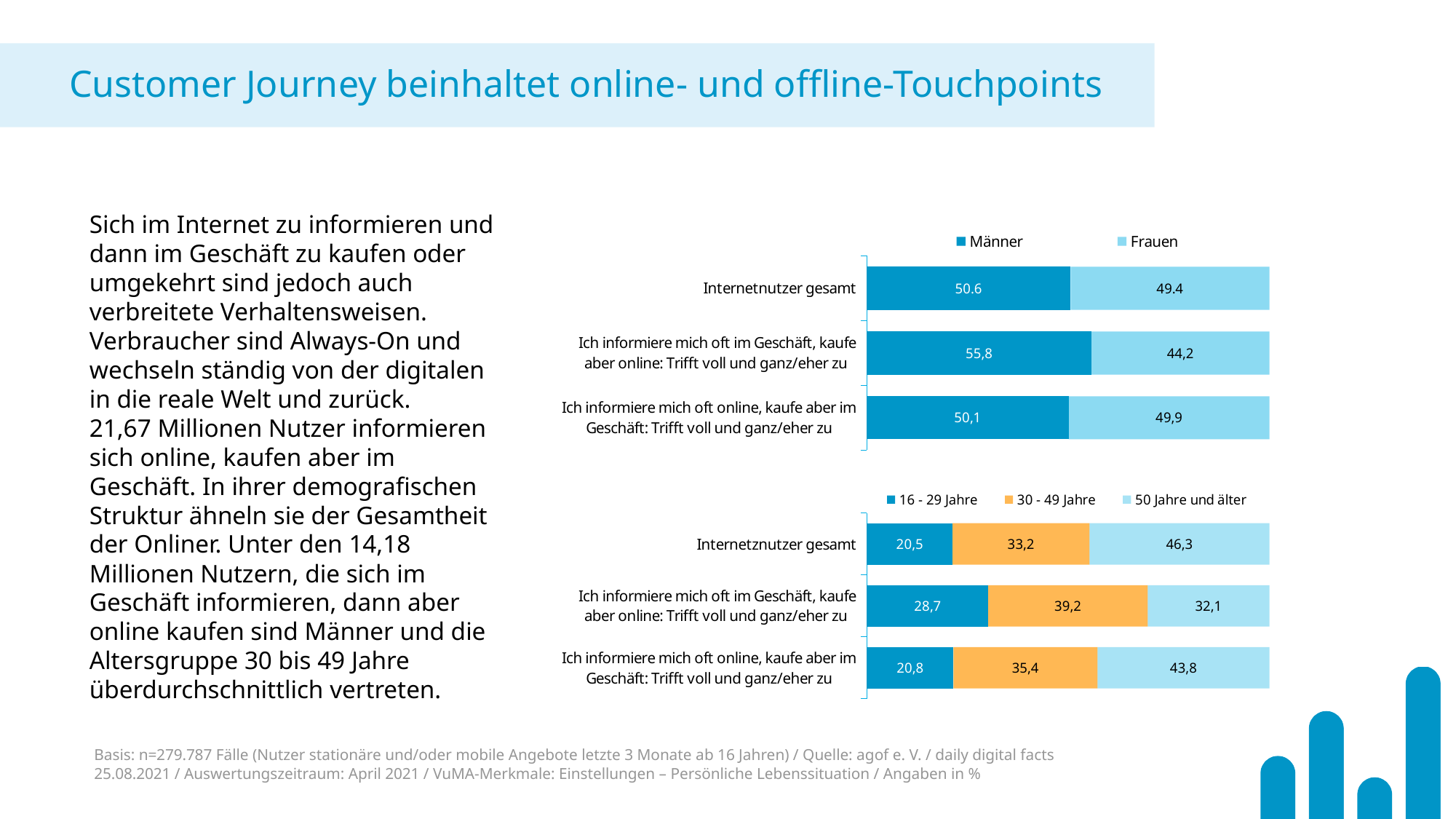
What kind of chart is the bottom chart (age groups)? Stacked bar chart In the top chart (Männer/Frauen), what is the Männer value for "Internetnutzer gesamt"? 50.6 In the bottom chart (age groups), what is the "30 - 49 Jahre" value for "Ich informiere mich oft im Geschäft, kaufe aber online"? 39,2 In the bottom chart (age groups), which category has the lowest "50 Jahre und älter" value? Ich informiere mich oft im Geschäft, kaufe aber online: Trifft voll und ganz/eher zu In the bottom chart (age groups), is the "16 - 29 Jahre" value larger for "Ich informiere mich oft im Geschäft, kaufe aber online" or for "Ich informiere mich oft online, kaufe aber im Geschäft"? Ich informiere mich oft im Geschäft, kaufe aber online In the top chart (Männer/Frauen), how many series does the legend list? 2 In the top chart (Männer/Frauen), what is the Frauen value for "Ich informiere mich oft im Geschäft, kaufe aber online"? 44,2 In the bottom chart (age groups), how many series does the legend list? 3 In the top chart (Männer/Frauen), which category has the highest Männer value? Ich informiere mich oft im Geschäft, kaufe aber online: Trifft voll und ganz/eher zu In the bottom chart (age groups), how many categories are shown? 3 In the top chart (Männer/Frauen), what is the difference between the Männer and Frauen values for "Ich informiere mich oft im Geschäft, kaufe aber online"? 11,6 In the bottom chart (age groups), what is the "50 Jahre und älter" value for "Internetznutzer gesamt"? 46,3